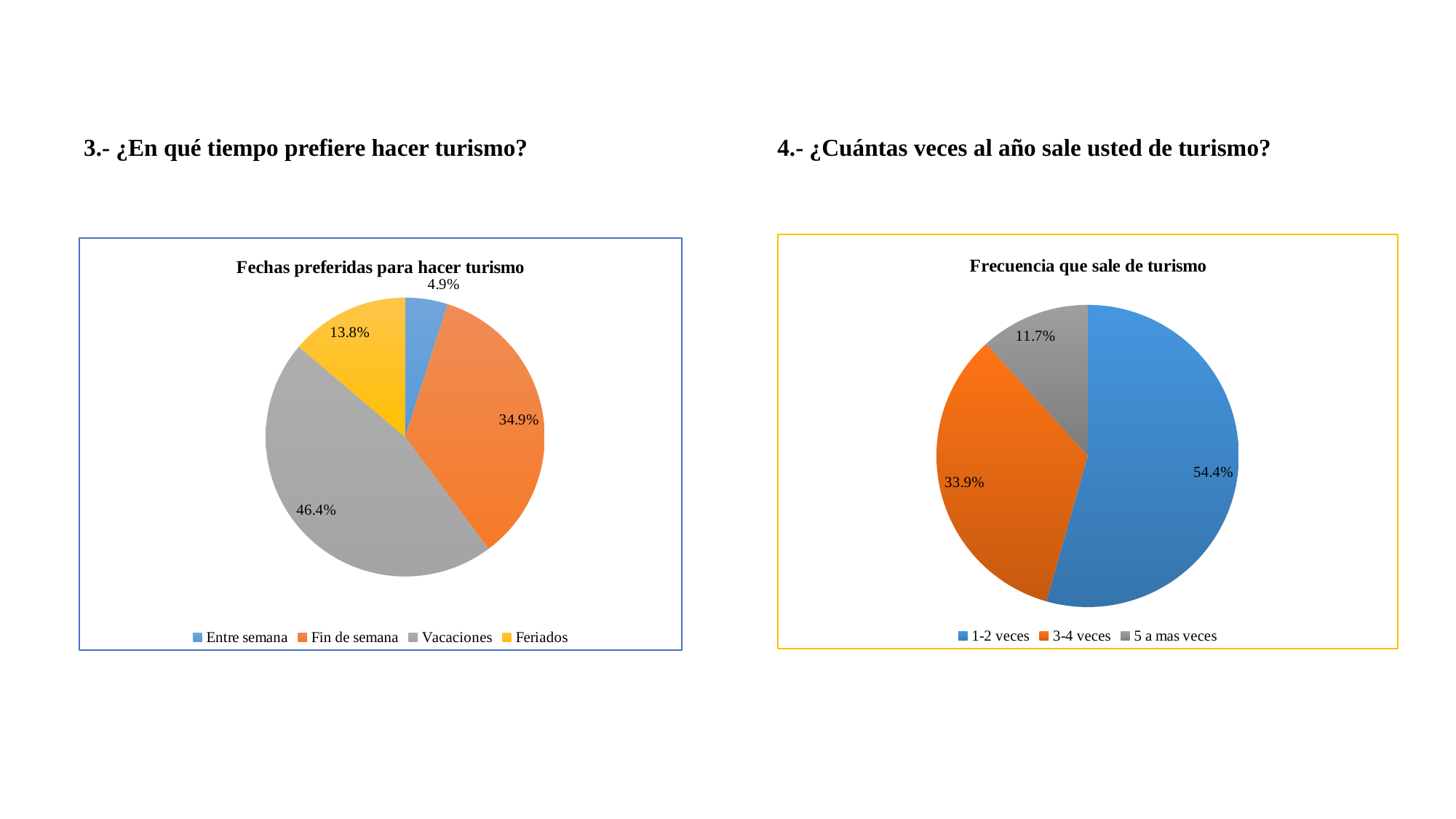
In the chart titled 'Frecuencia que sale de turismo', what share does 5 a mas veces have? 11.7% In the chart titled 'Frecuencia que sale de turismo', what colour is the 3-4 veces slice? Orange In the chart titled 'Fechas preferidas para hacer turismo', what share does Entre semana have? 4.9% In the chart titled 'Frecuencia que sale de turismo', which is larger: 3-4 veces or 5 a mas veces? 3-4 veces In the chart titled 'Fechas preferidas para hacer turismo', which category has the largest slice? Vacaciones In the chart titled 'Fechas preferidas para hacer turismo', what is the difference between the Fin de semana and Feriados shares? 21.1% In the chart titled 'Frecuencia que sale de turismo', which category has the largest slice? 1-2 veces In the chart titled 'Fechas preferidas para hacer turismo', how many categories does the legend list? 4 What type of chart is 'Fechas preferidas para hacer turismo'? Pie chart In the chart titled 'Fechas preferidas para hacer turismo', what share does Vacaciones have? 46.4% In the chart titled 'Fechas preferidas para hacer turismo', which category has the smallest slice? Entre semana In the chart titled 'Frecuencia que sale de turismo', what share does 1-2 veces have? 54.4%